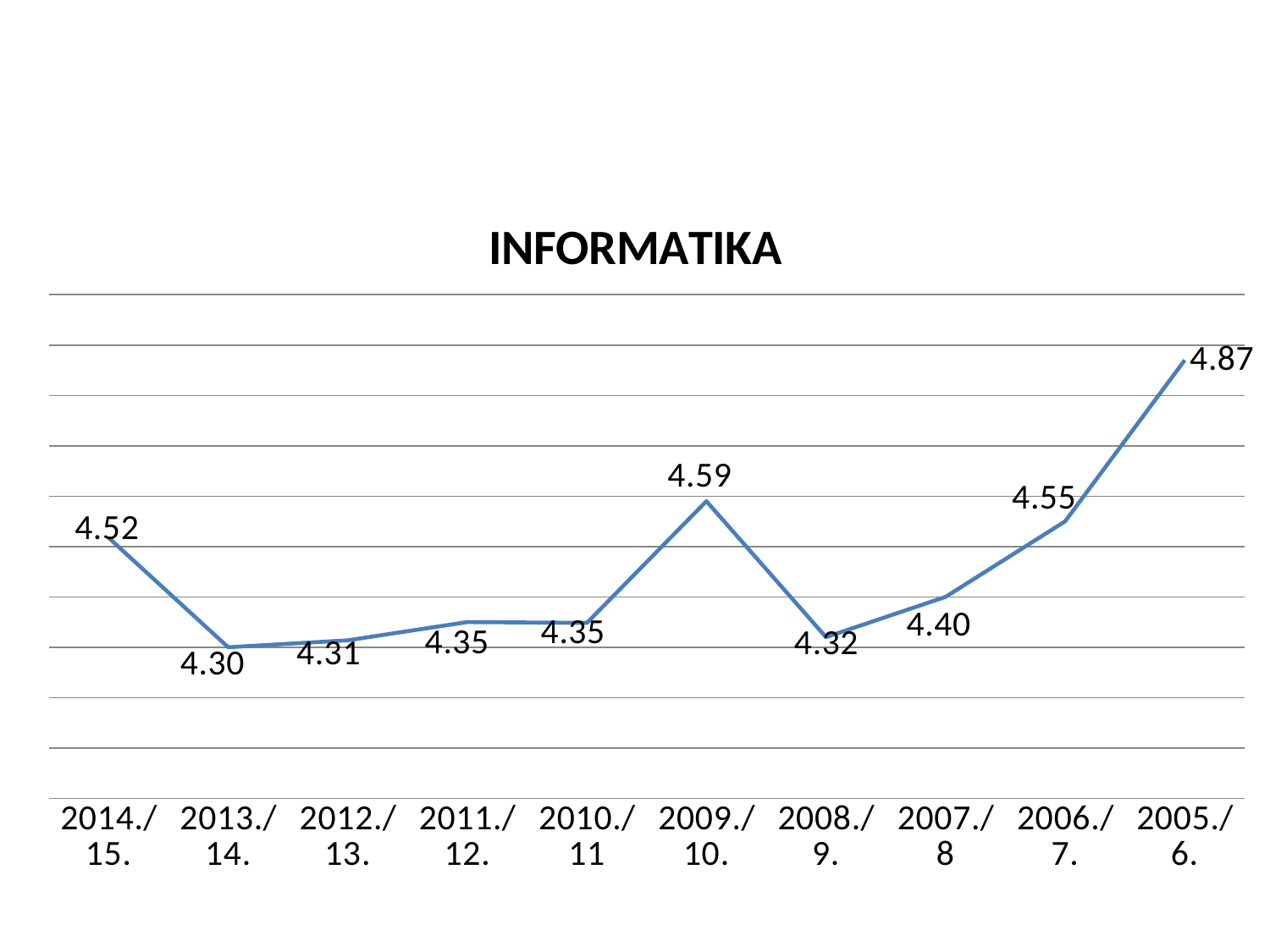
What is the value for 2009./10.? 4.59 Which school year has the highest value? 2005./6. What is the difference between the values for 2009./10. and 2010./11? 0.24 Which is larger, the value for 2006./7. or the value for 2008./9.? 2006./7. What kind of chart is shown? line chart What is the difference between the values for 2005./6. and 2013./14.? 0.57 What is the value for 2014./15.? 4.52 How many school years are plotted on the chart? 10 Does the value rise or fall from 2008./9. to 2005./6. along the x axis? rise What is the title of the chart? INFORMATIKA What is the value for 2007./8? 4.40 Which school year has the lowest value? 2013./14.